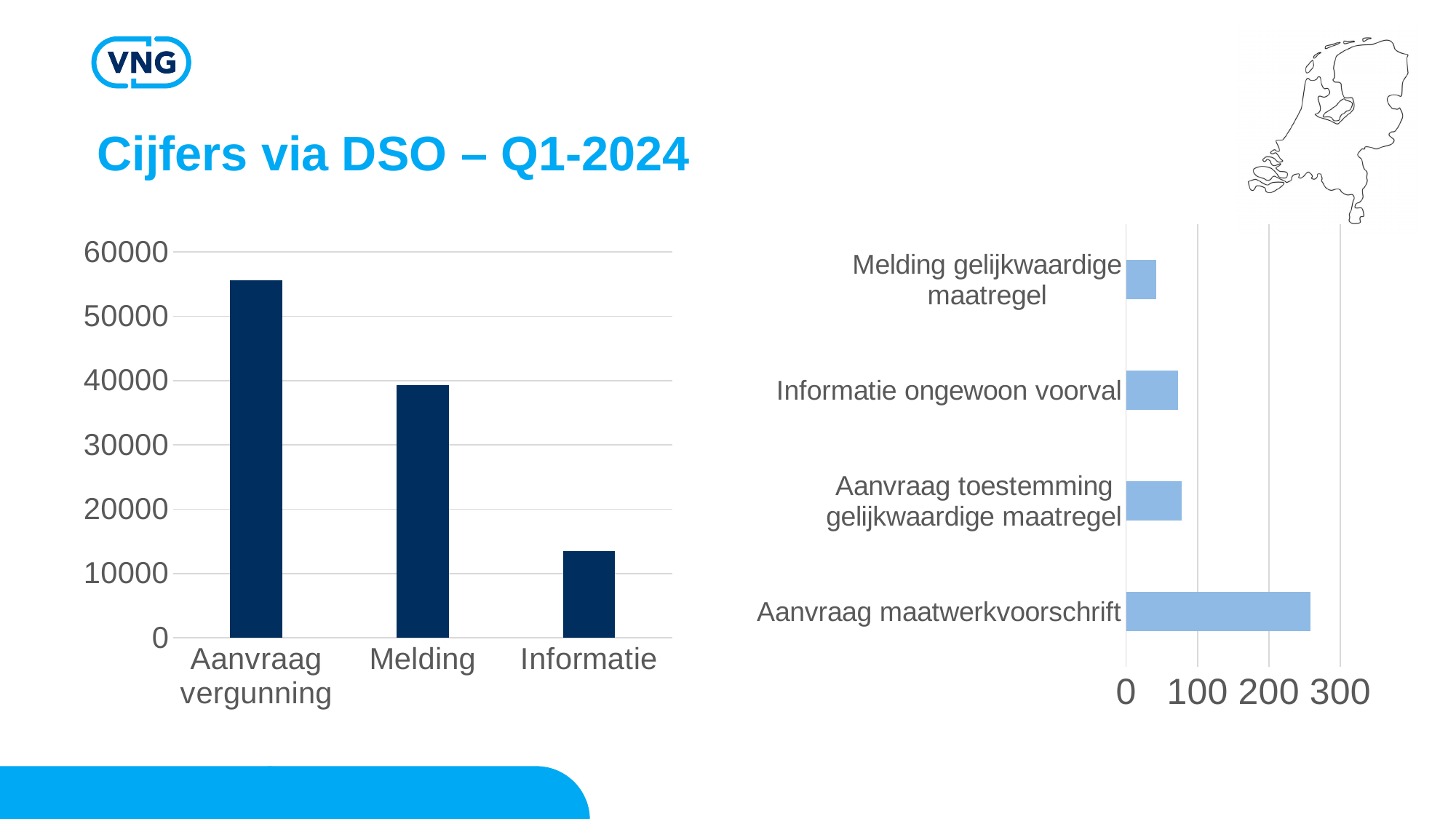
On the right chart, which category has the lowest value? Melding gelijkwaardige maatregel On the right chart, which category has the highest value? Aanvraag maatwerkvoorschrift What kind of chart is the chart on the right? bar chart On the left chart, is the value for Aanvraag vergunning greater or less than 50000? greater On the left chart, is the value for Informatie greater or less than 20000? less On the left chart, which category has the lowest value? Informatie On the right chart, is the value for Informatie ongewoon voorval greater or less than 100? less On the left chart, which category has the highest value? Aanvraag vergunning On the left chart, do the values rise or fall from left to right? fall On the left chart, how many categories are shown? 3